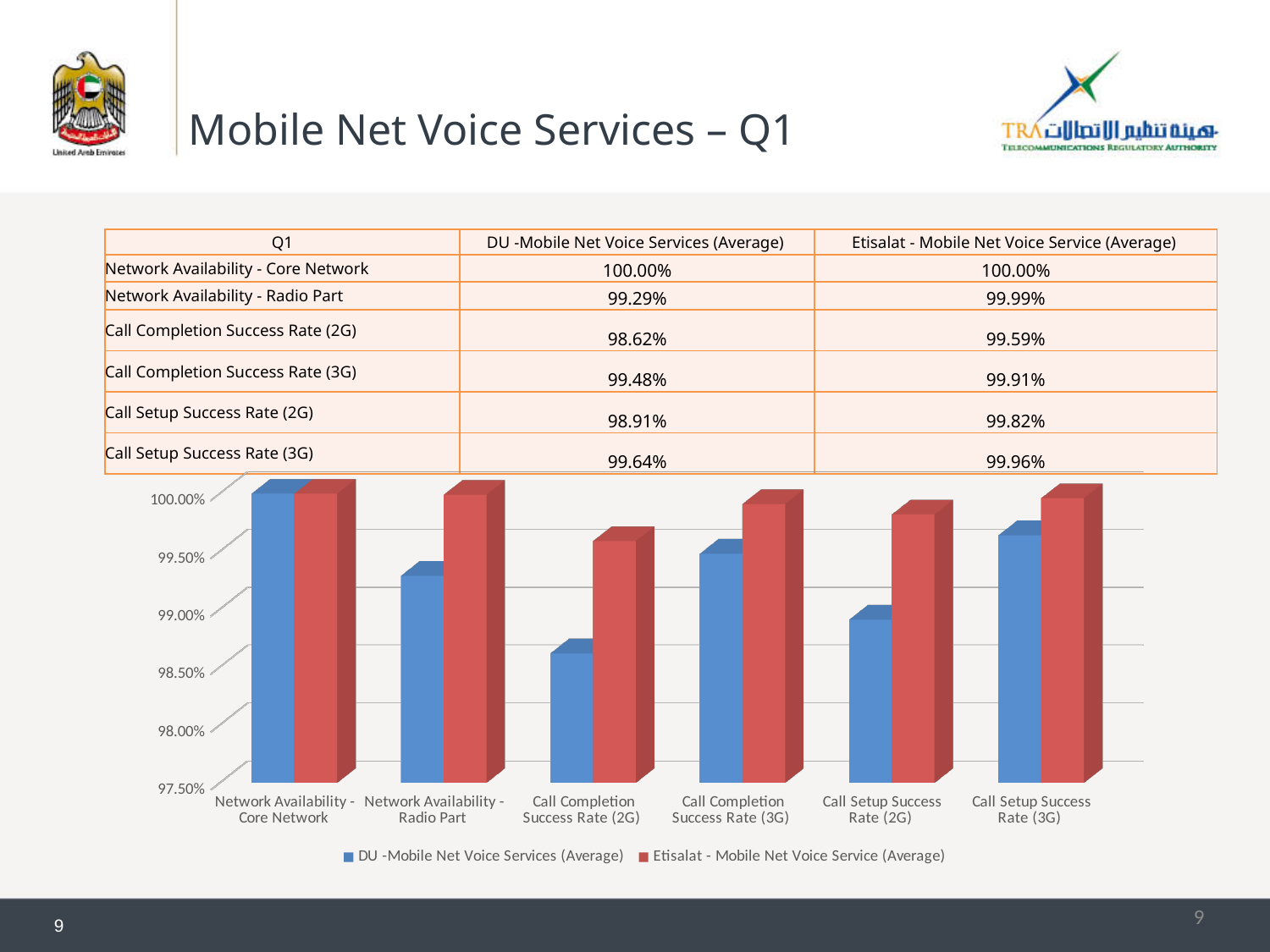
Which category has the lowest DU value? Call Completion Success Rate (2G) What is the difference between the Etisalat and DU values for Call Setup Success Rate (2G)? 0.91% Which category has the lowest Etisalat value? Call Completion Success Rate (2G) What is the DU value for Call Completion Success Rate (2G)? 98.62% How many series does the chart legend list? 2 What is the Etisalat value for Call Setup Success Rate (3G)? 99.96% What kind of chart is shown on the slide? bar chart For Network Availability - Radio Part, which is larger: the DU value or the Etisalat value? Etisalat What is the DU value for Network Availability - Radio Part? 99.29% Is the DU value for Call Setup Success Rate (2G) greater or less than 99.00%? less What colour are the bars for the DU series in the chart? blue How many categories are plotted along the x axis of the chart? 6